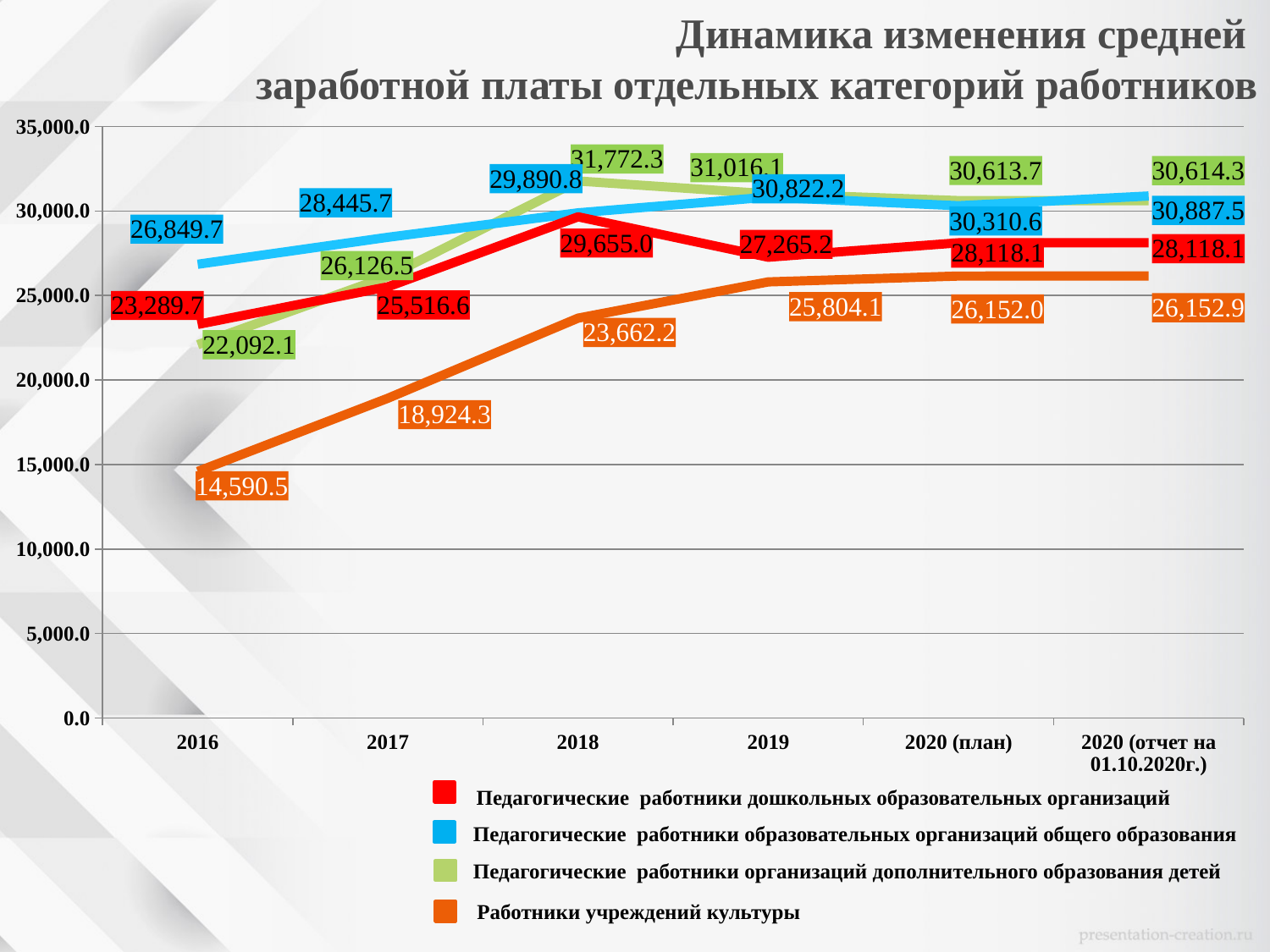
In which year is the value for Педагогические работники дошкольных образовательных организаций highest? 2018 What type of chart is shown on the slide? line chart What is the value for Педагогические работники образовательных организаций общего образования in 2020 (отчет на 01.10.2020г.)? 30,887.5 Which colour represents Работники учреждений культуры in the legend? orange What is the value for Педагогические работники организаций дополнительного образования детей in 2018? 31,772.3 What is the difference between the 2017 and 2016 values for Работники учреждений культуры? 4,333.8 In which year is the value for Работники учреждений культуры lowest? 2016 How many categories are shown on the x axis? 6 Which series has the larger value in 2016: Педагогические работники дошкольных образовательных организаций or Работники учреждений культуры? Педагогические работники дошкольных образовательных организаций How many series does the legend list? 4 What is the value for Работники учреждений культуры in 2016? 14,590.5 Does the value for Работники учреждений культуры rise or fall from 2016 to 2019? rise